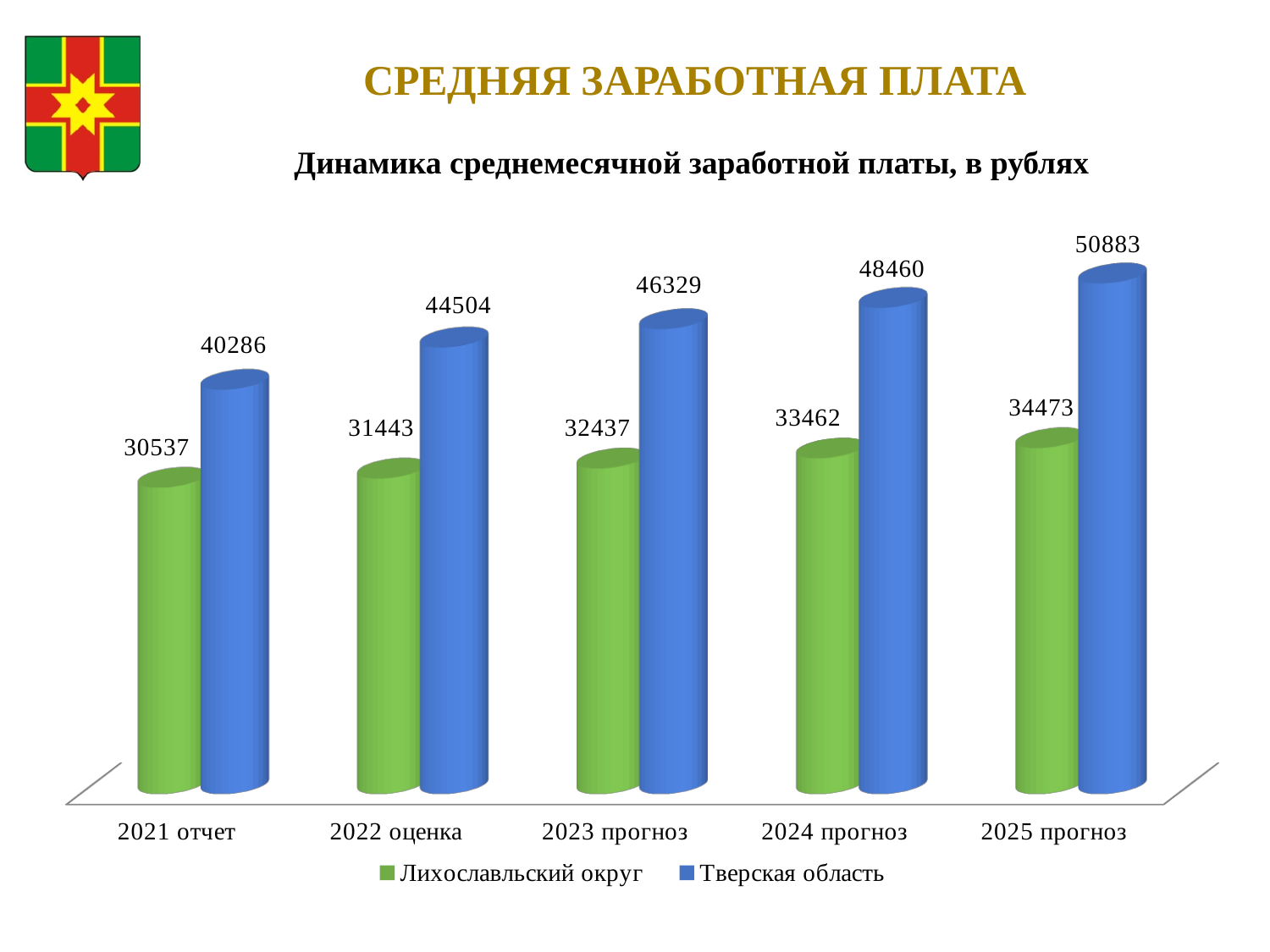
What is the value for Лихославльский округ in 2021 отчет? 30537 What is the value for Тверская область in 2025 прогноз? 50883 Do the values for Лихославльский округ rise or fall from 2021 отчет to 2025 прогноз? rise What is the value for Тверская область in 2023 прогноз? 46329 How many series does the legend list? 2 How many categories are shown on the x axis? 5 Which is larger in 2022 оценка: Лихославльский округ or Тверская область? Тверская область What is the value for Лихославльский округ in 2024 прогноз? 33462 In which category is the value for Лихославльский округ the lowest? 2021 отчет In which category is the value for Тверская область the highest? 2025 прогноз What is the difference between Тверская область and Лихославльский округ in 2021 отчет? 9749 What is the difference between Тверская область and Лихославльский округ in 2025 прогноз? 16410